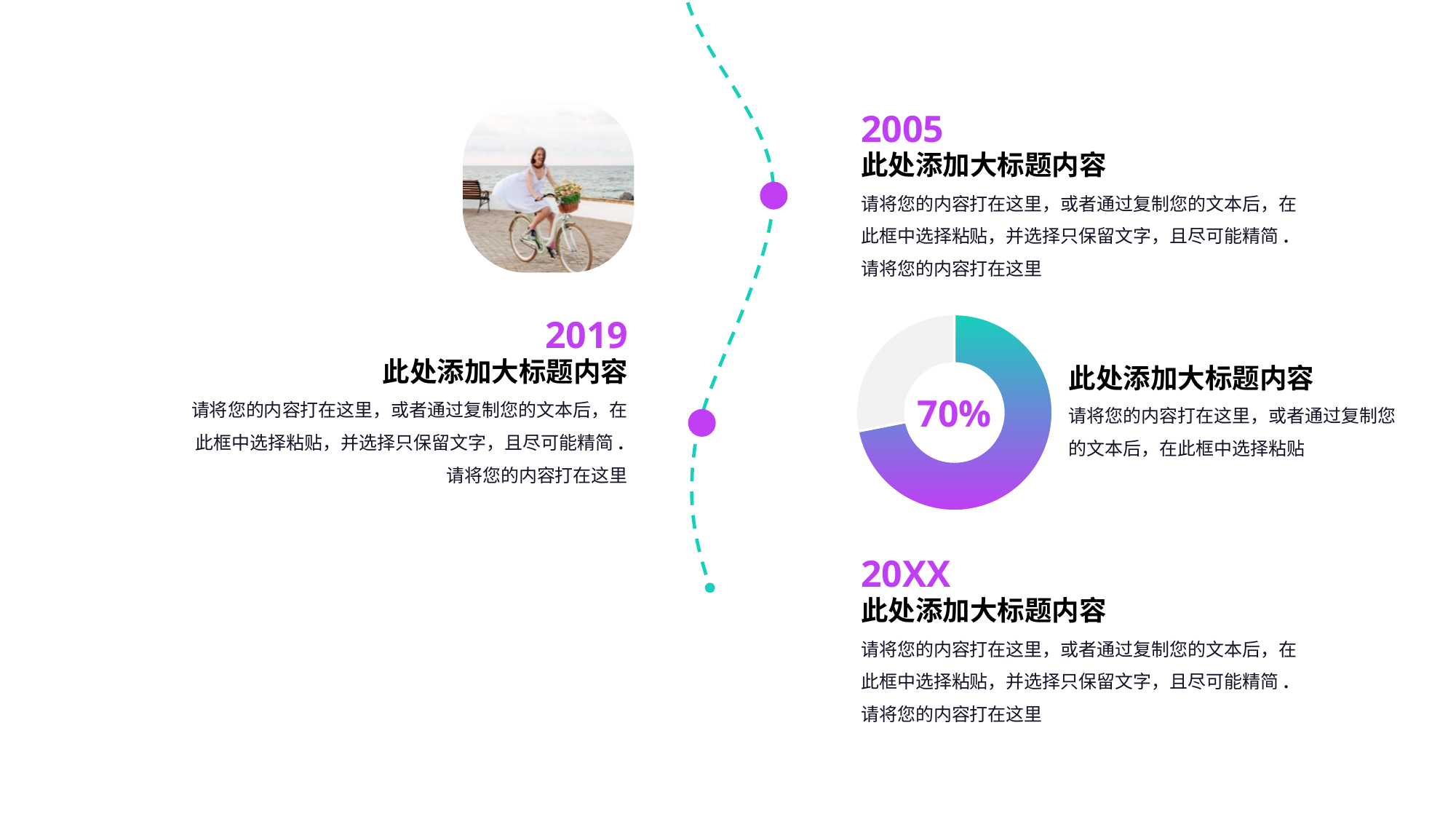
What kind of chart is shown on the slide? Donut chart Is the coloured slice of the donut chart greater or less than 50%? greater What share of the donut chart does the coloured (teal-to-purple) slice represent? 70% What colour is the smaller slice of the donut chart? Grey What share of the donut chart does the grey slice represent? 30% How many slices does the donut chart have? 2 What percentage is printed in the centre of the donut chart? 70% Which slice of the donut chart is larger, the coloured slice or the grey slice? The coloured slice